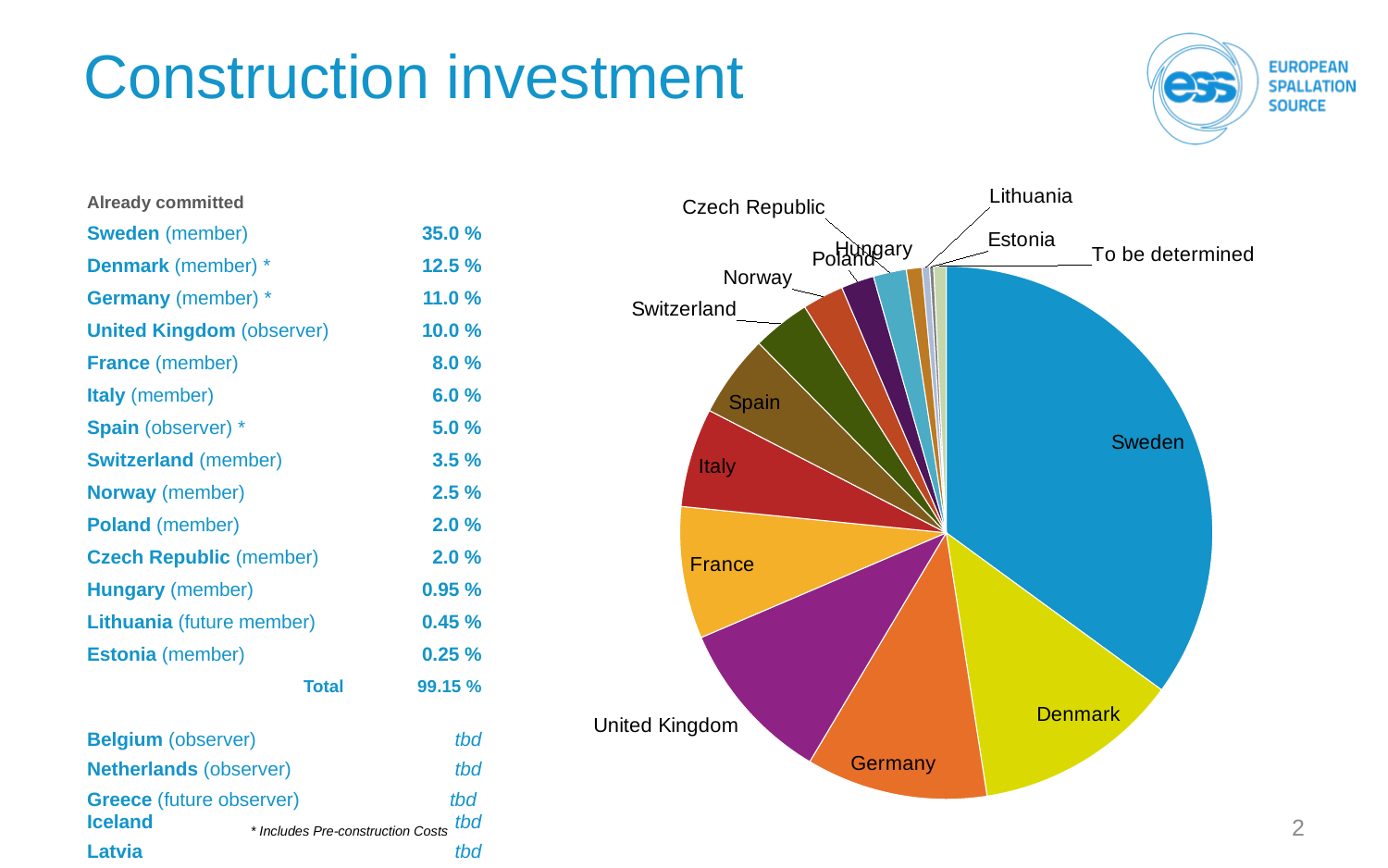
What is the total share already committed, as shown on the slide? 99.15 % By how many percentage points does Sweden's share exceed Denmark's share, according to the slide? 22.5 % What kind of chart is shown on the slide? pie chart According to the slide, what share of the construction investment does the United Kingdom hold? 10.0 % What is the title of the slide containing the pie chart? Construction investment Which slice is larger in the pie chart, Spain or Switzerland? Spain Which slice of the pie chart is the largest? Sweden According to the slide, what share of the construction investment does Sweden hold? 35.0 % According to the slide, what share of the construction investment does Denmark hold? 12.5 % Which slice is larger in the pie chart, Sweden or Denmark? Sweden How many slices does the pie chart have? 15 Which slice is larger in the pie chart, France or Italy? France